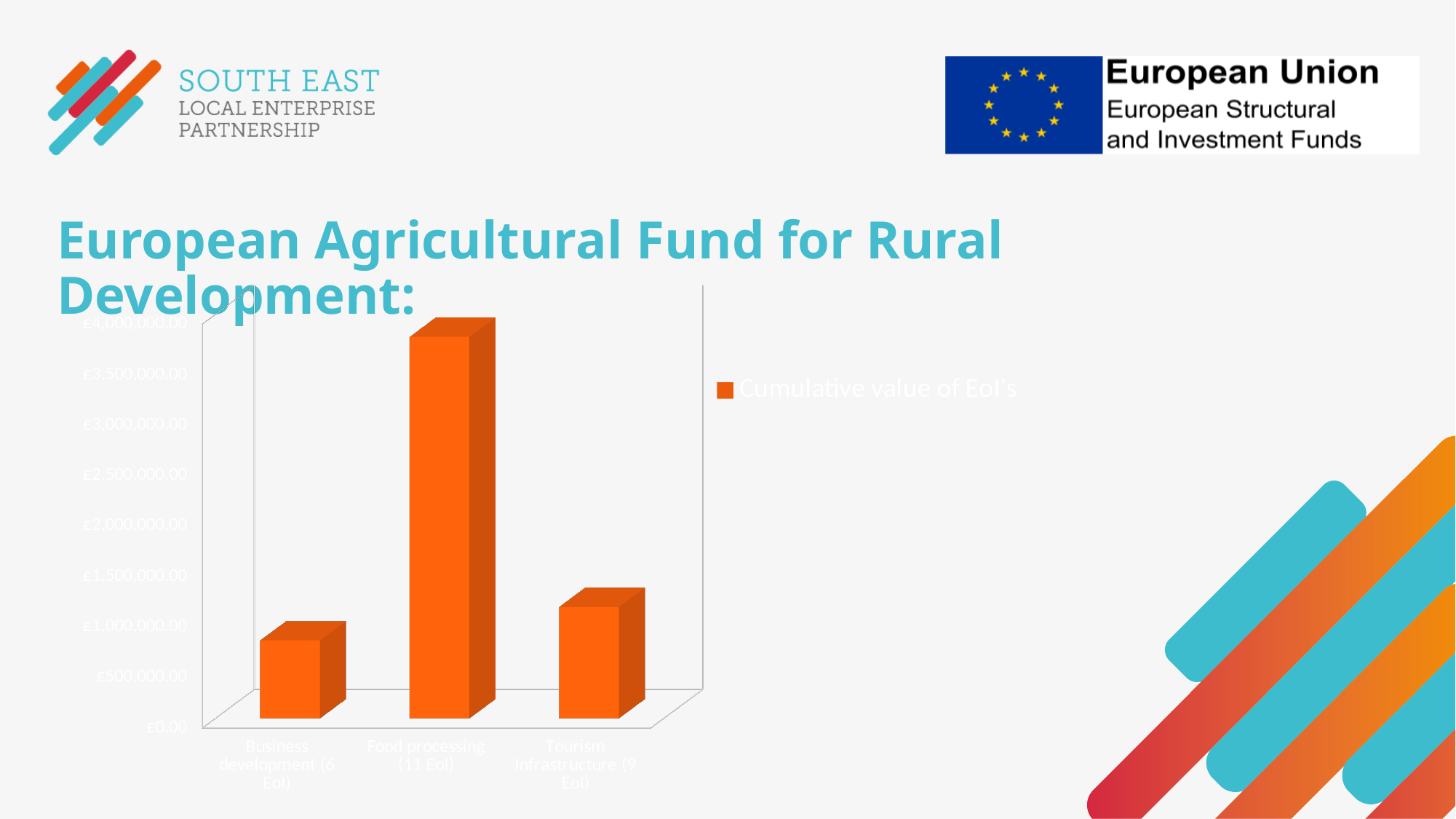
How many series does the chart legend list? 1 What is the highest value shown on the chart's vertical axis? £4,000,000.00 Is the value for Tourism Infrastructure (9 EoI) greater or less than £1,500,000.00? less How many categories are shown on the x axis of the chart? 3 Is the value for Food processing (11 EoI) greater or less than £3,500,000.00? greater What kind of chart is shown on the slide? bar chart Which category has the highest cumulative value of EoI's? Food processing (11 EoI) What is the name of the series shown in the chart legend? Cumulative value of EoI's Which category has the lowest cumulative value of EoI's? Business development (6 EoI) Is the value for Business development (6 EoI) greater or less than £1,000,000.00? less Which has a larger cumulative value of EoI's: Tourism Infrastructure (9 EoI) or Business development (6 EoI)? Tourism Infrastructure (9 EoI)